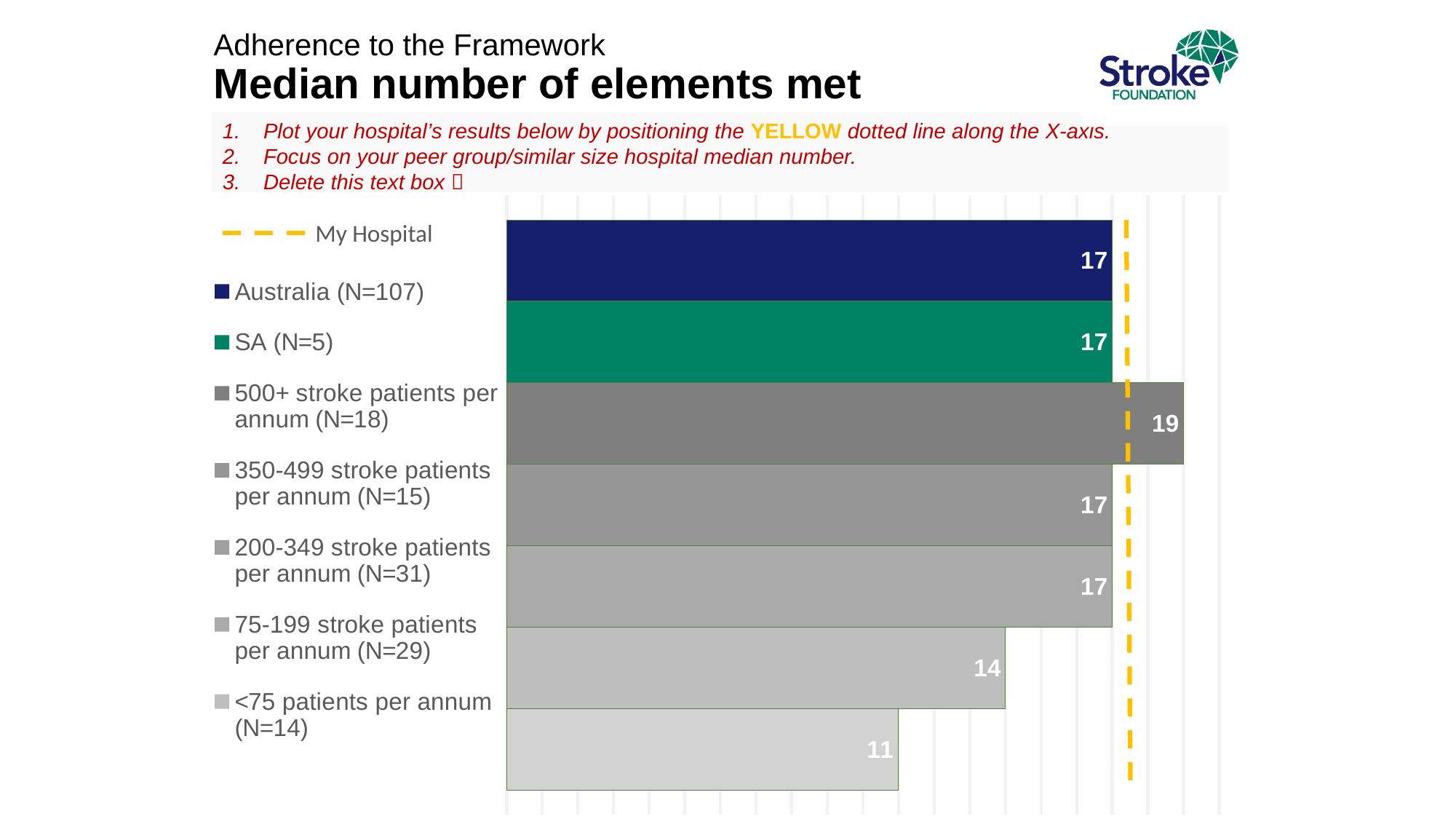
Which is larger: the median for 75-199 stroke patients per annum or for 200-349 stroke patients per annum? 200-349 stroke patients per annum What is the difference between the median number of elements met for 500+ stroke patients per annum and <75 patients per annum? 8 Which group has the highest median number of elements met? 500+ stroke patients per annum (N=18) What colour is the dotted 'My Hospital' line in the chart? Yellow What type of chart is shown on the slide? Bar chart What is the median number of elements met for hospitals with 75-199 stroke patients per annum (N=29)? 14 What is the median number of elements met for SA (N=5)? 17 What is the median number of elements met for hospitals with 500+ stroke patients per annum (N=18)? 19 What is the median number of elements met for Australia (N=107)? 17 Which group has the lowest median number of elements met? <75 patients per annum (N=14) How many bars are plotted in the chart? 7 What is the median number of elements met for hospitals with <75 patients per annum (N=14)? 11